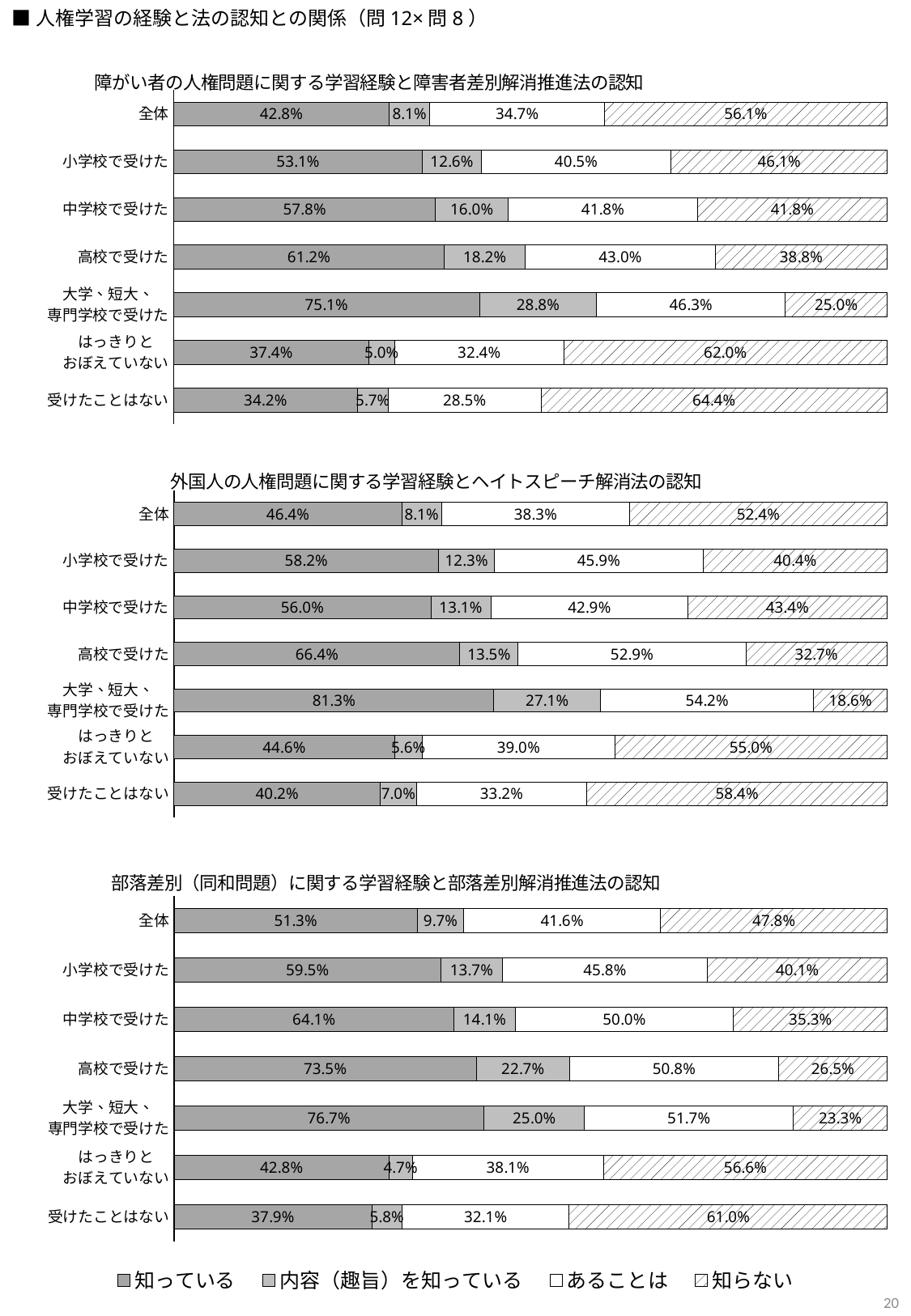
In the bottom chart (部落差別（同和問題）に関する学習経験と部落差別解消推進法の認知), which category has the lowest 知らない value? 大学、短大、専門学校で受けた Which legend entry is shown with a hatched (diagonal line) pattern? 知らない In the middle chart (外国人の人権問題に関する学習経験とヘイトスピーチ解消法の認知), which category has the highest 知っている value? 大学、短大、専門学校で受けた In the middle chart (外国人の人権問題に関する学習経験とヘイトスピーチ解消法の認知), which is larger: the 知らない value for 小学校で受けた or for 中学校で受けた? 中学校で受けた In the top chart (障がい者の人権問題に関する学習経験と障害者差別解消推進法の認知), what is the 知っている value for 大学、短大、専門学校で受けた? 75.1% In the top chart (障がい者の人権問題に関する学習経験と障害者差別解消推進法の認知), what is the 知らない value for 受けたことはない? 64.4% In the top chart (障がい者の人権問題に関する学習経験と障害者差別解消推進法の認知), what is the difference between the 知っている values for 高校で受けた and 全体? 18.4% In the middle chart (外国人の人権問題に関する学習経験とヘイトスピーチ解消法の認知), what is the 内容（趣旨）を知っている value for 高校で受けた? 13.5% How many series does the legend at the bottom of the slide list? 4 How many categories are shown on the vertical axis of the bottom chart (部落差別（同和問題）に関する学習経験と部落差別解消推進法の認知)? 7 In the bottom chart (部落差別（同和問題）に関する学習経験と部落差別解消推進法の認知), what is the あることは value for 中学校で受けた? 50.0% What kind of chart is the top chart (障がい者の人権問題に関する学習経験と障害者差別解消推進法の認知)? Stacked bar chart